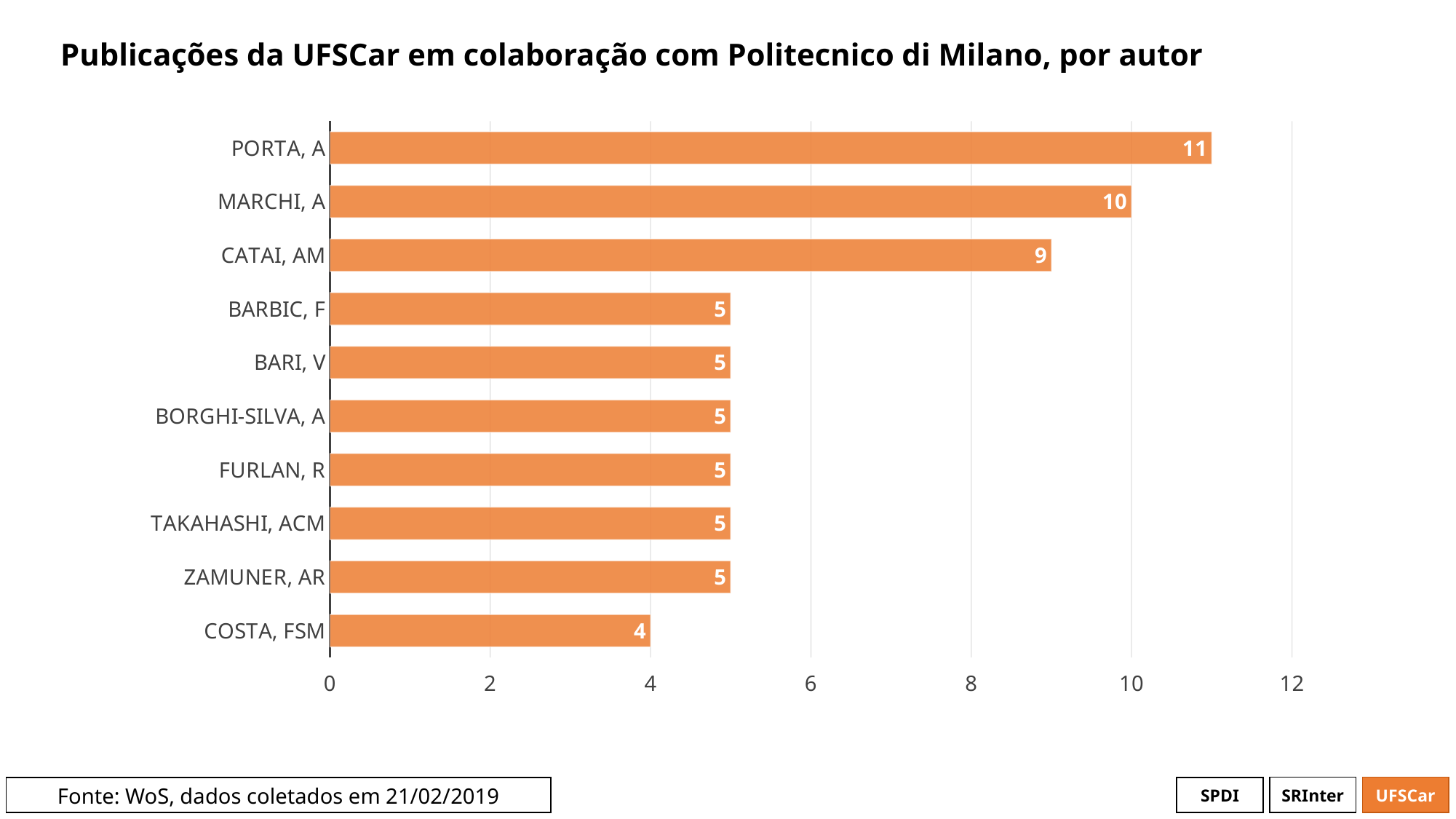
What is the title of the chart? Publicações da UFSCar em colaboração com Politecnico di Milano, por autor What is the value for CATAI, AM? 9 What kind of chart is shown on the slide? bar chart How many authors are shown in the chart? 10 Which author has the highest number of publications? PORTA, A What is the value for COSTA, FSM? 4 Is the value for CATAI, AM greater or less than 8? greater How many publications does PORTA, A have? 11 What is the difference between the values for CATAI, AM and COSTA, FSM? 5 What is the difference between the values for PORTA, A and MARCHI, A? 1 Which author has the lowest number of publications? COSTA, FSM Which is larger, the value for MARCHI, A or the value for BARBIC, F? MARCHI, A